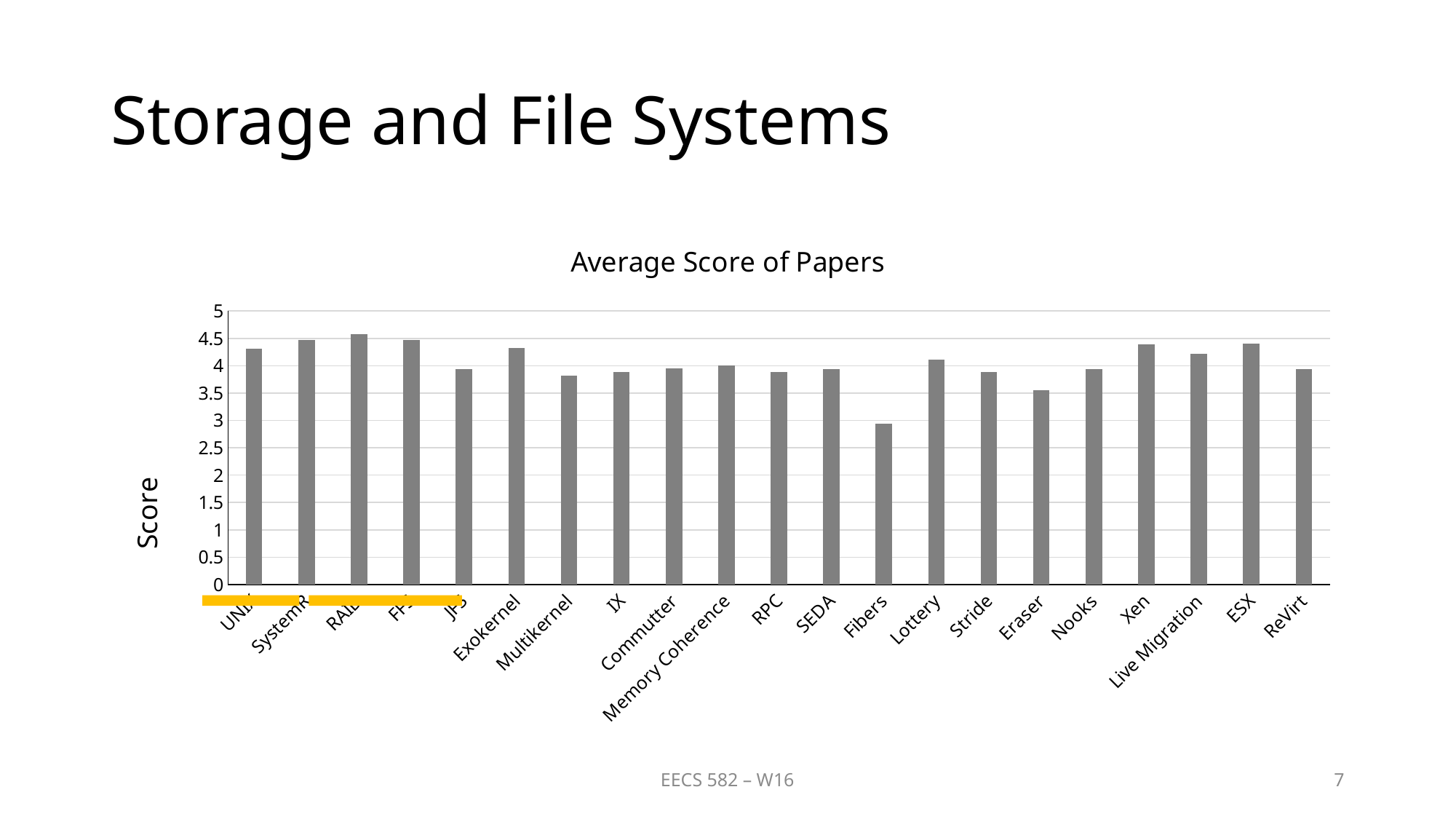
Is the value for Exokernel greater or less than 4? greater What is the title of the chart? Average Score of Papers Which has the higher average score, Xen or Eraser? Xen How many papers (bars) are plotted in the chart? 21 Is the value for Eraser greater or less than 4? less What is the label on the vertical axis of the chart? Score What kind of chart is shown on the slide? bar chart Which has the higher average score, Exokernel or Multikernel? Exokernel Is the value for Xen greater or less than 4? greater Which paper has the lowest average score? Fibers